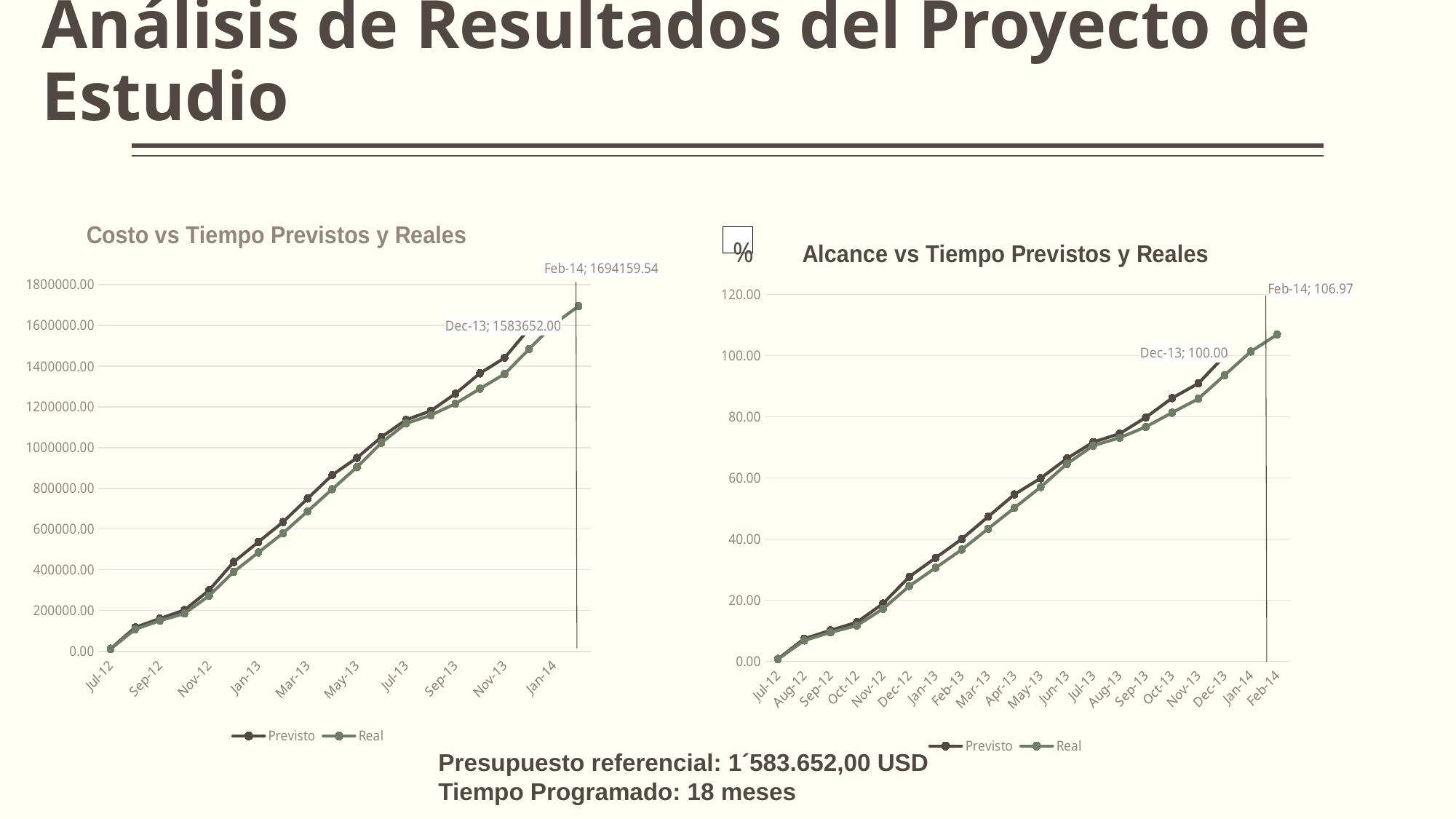
In the 'Alcance vs Tiempo Previstos y Reales' chart, is the Real value at Nov-13 greater or less than 80.00? greater In the 'Costo vs Tiempo Previstos y Reales' chart, what is the labelled value of the Real series at Feb-14? 1694159.54 In the 'Alcance vs Tiempo Previstos y Reales' chart, what is the labelled value of the Real series at Feb-14? 106.97 In the 'Costo vs Tiempo Previstos y Reales' chart, is the Real value at Jan-13 greater or less than 600000.00? less In the 'Alcance vs Tiempo Previstos y Reales' chart, how many series does the legend list? 2 In the 'Alcance vs Tiempo Previstos y Reales' chart, do the values rise or fall from Jul-12 to Feb-14? Rise In the 'Costo vs Tiempo Previstos y Reales' chart, which series is higher at Nov-13, Previsto or Real? Previsto In the 'Costo vs Tiempo Previstos y Reales' chart, what is the labelled value of the Previsto series at Dec-13? 1583652.00 In the 'Alcance vs Tiempo Previstos y Reales' chart, what is the labelled value of the Previsto series at Dec-13? 100.00 In the 'Costo vs Tiempo Previstos y Reales' chart, what is the difference between the labelled Real value at Feb-14 and the labelled Previsto value at Dec-13? 110507.54 In the 'Alcance vs Tiempo Previstos y Reales' chart, what is the difference between the labelled Real value at Feb-14 and the labelled Previsto value at Dec-13? 6.97 What kind of chart is 'Costo vs Tiempo Previstos y Reales'? Line chart